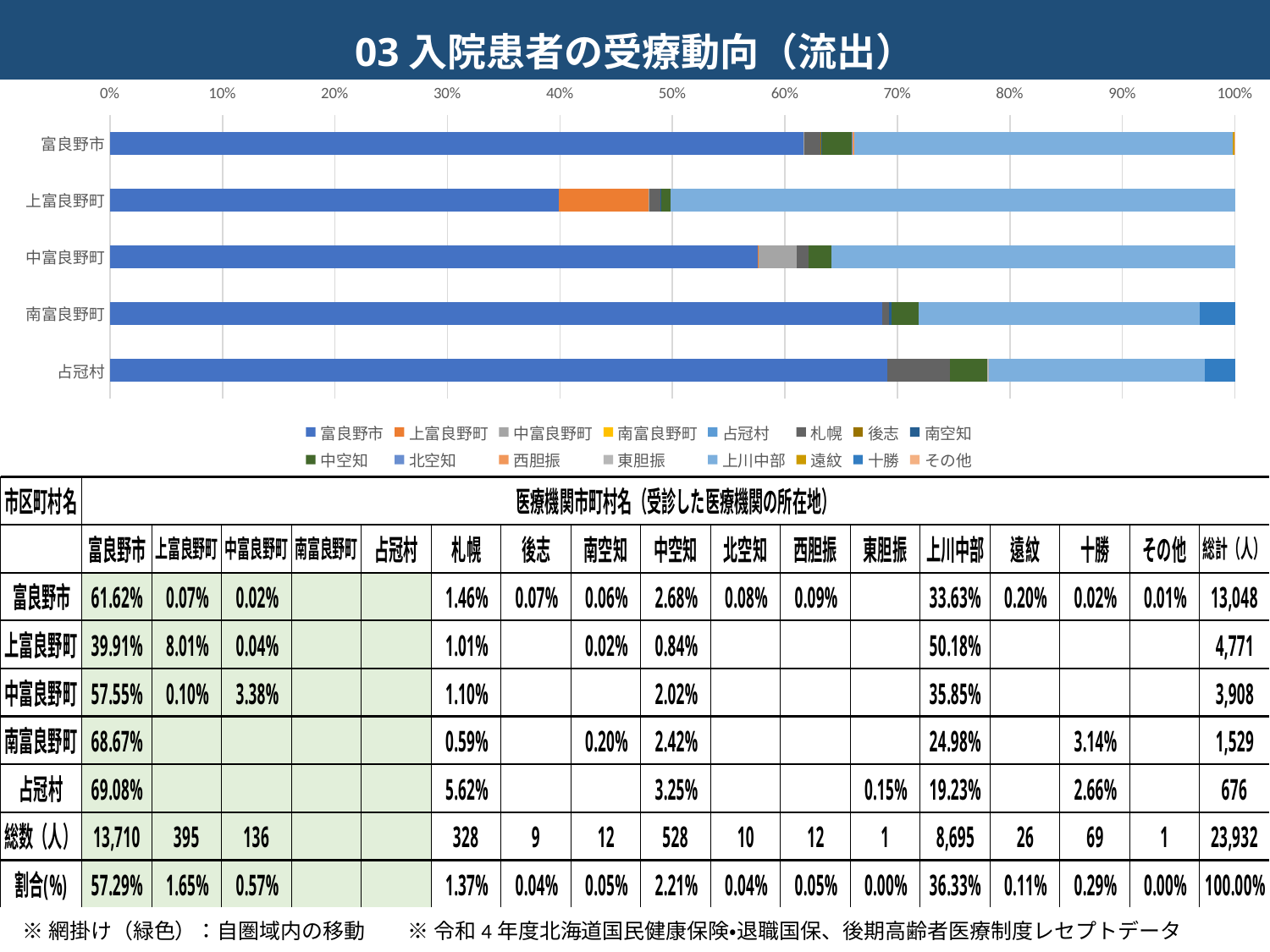
Is the 富良野市 segment for 上富良野町 greater or less than 50%? less What is the 札幌 share for 占冠村? 5.62% Which has the larger 上川中部 segment, 上富良野町 or 南富良野町? 上富良野町 What is the 上川中部 share for 富良野市? 33.63% What kind of chart is shown on the slide? bar chart How many municipalities (categories) are plotted on the y axis of the chart? 5 What is the difference between the 富良野市 share for 中富良野町 and for 上富良野町? 17.64% Is the 富良野市 segment for 中富良野町 greater or less than 50%? greater Which municipality has the smallest 富良野市 segment in its bar? 上富良野町 How many series does the chart legend list? 16 What is the title of the slide containing the chart? 03 入院患者の受療動向（流出） What is the 上富良野町 share for 上富良野町? 8.01%